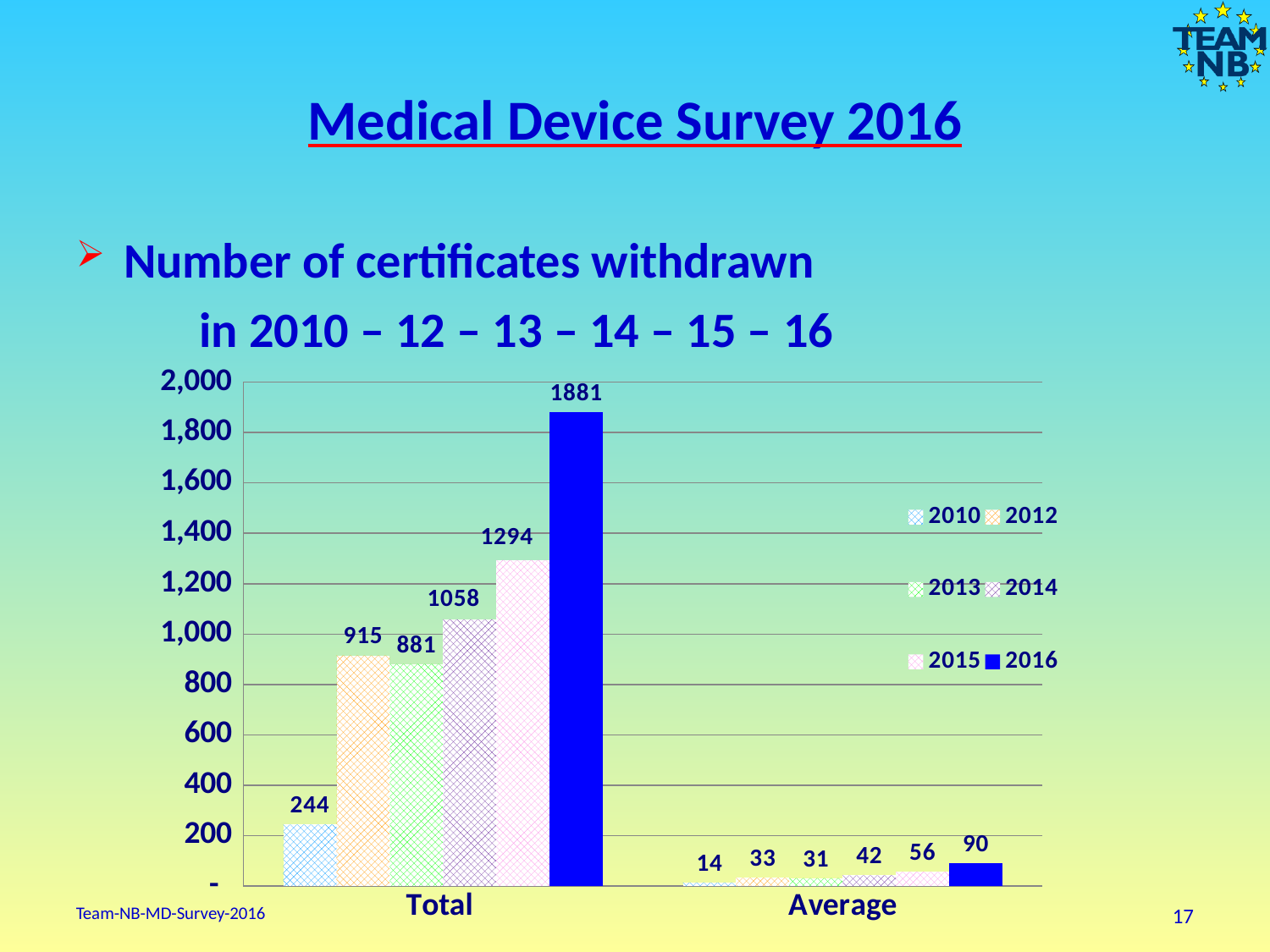
Which year has the lowest Average value? 2010 What is the Total number of certificates withdrawn for 2016? 1881 What is the difference between the Average values for 2016 and 2015? 34 How many categories are shown on the x axis? 2 What is the difference between the Total values for 2016 and 2015? 587 What kind of chart is shown on the slide? bar chart Which series is drawn as a solid blue bar in the legend? 2016 Which is larger, the Total value for 2012 or for 2013? 2012 How many series does the legend list? 6 What is the Total value for 2014? 1058 What is the Average value for 2010? 14 Which year has the highest Total number of certificates withdrawn? 2016